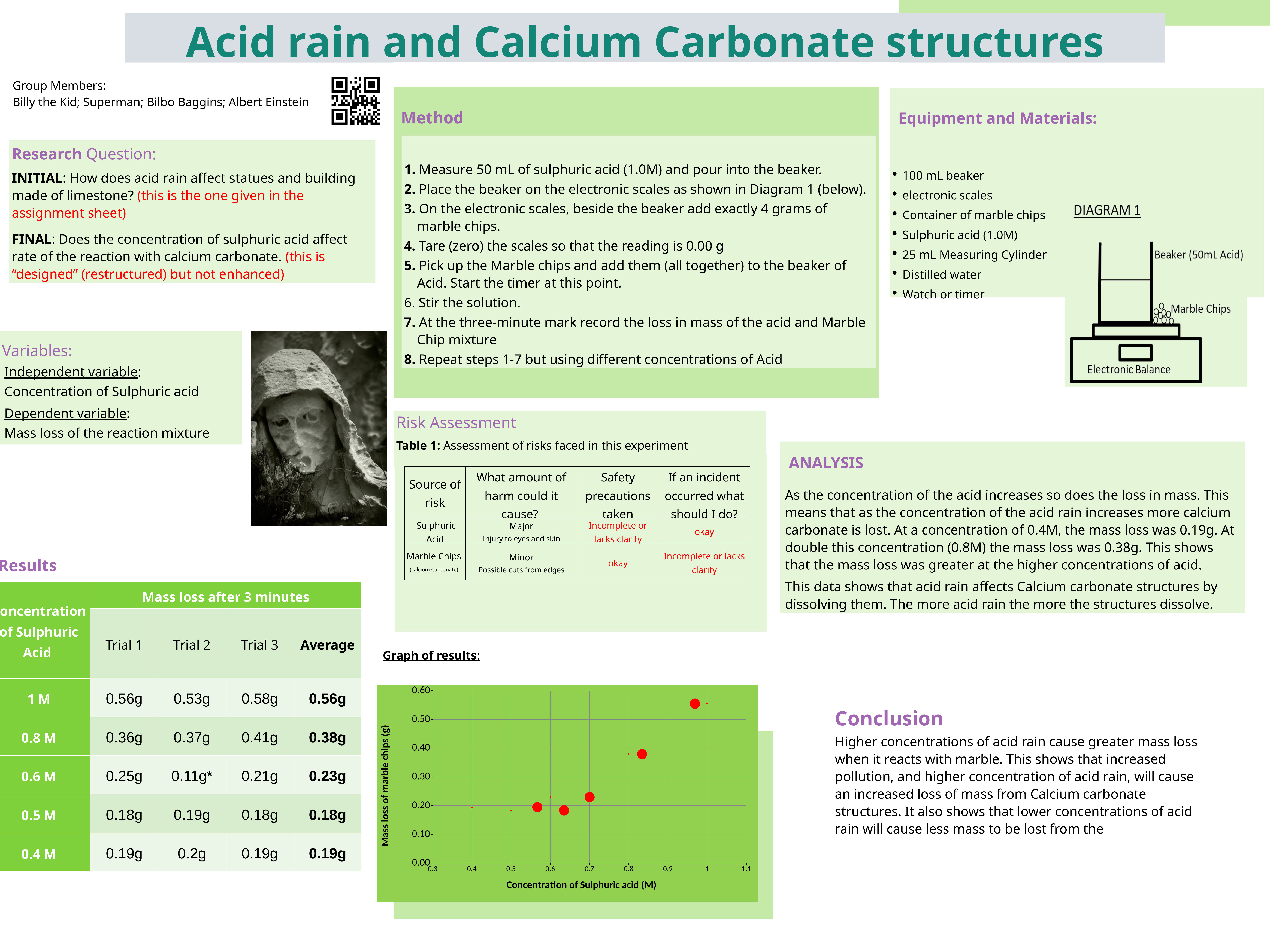
What is the x-axis label of the 'Graph of results' chart? Concentration of Sulphuric acid (M) In the 'Graph of results' chart, does the mass loss rise or fall as the concentration of sulphuric acid increases? rise What kind of chart is the 'Graph of results'? scatter chart In the 'Graph of results' chart, is the mass loss at a concentration of 0.8 M greater or less than 0.30 g? greater In the 'Graph of results' chart, is the mass loss at a concentration of 0.6 M greater or less than 0.30 g? less In the 'Graph of results' chart, which has the larger mass loss: the point at 0.8 M or the point at 0.5 M? 0.8 M In the 'Graph of results' chart, is the mass loss at a concentration of 0.4 M greater or less than 0.30 g? less In the 'Graph of results' chart, does the highest mass loss occur at the highest or the lowest concentration plotted? highest What is the y-axis label of the 'Graph of results' chart? Mass loss of marble chips (g) How many large red data points are plotted in the 'Graph of results' chart? 5